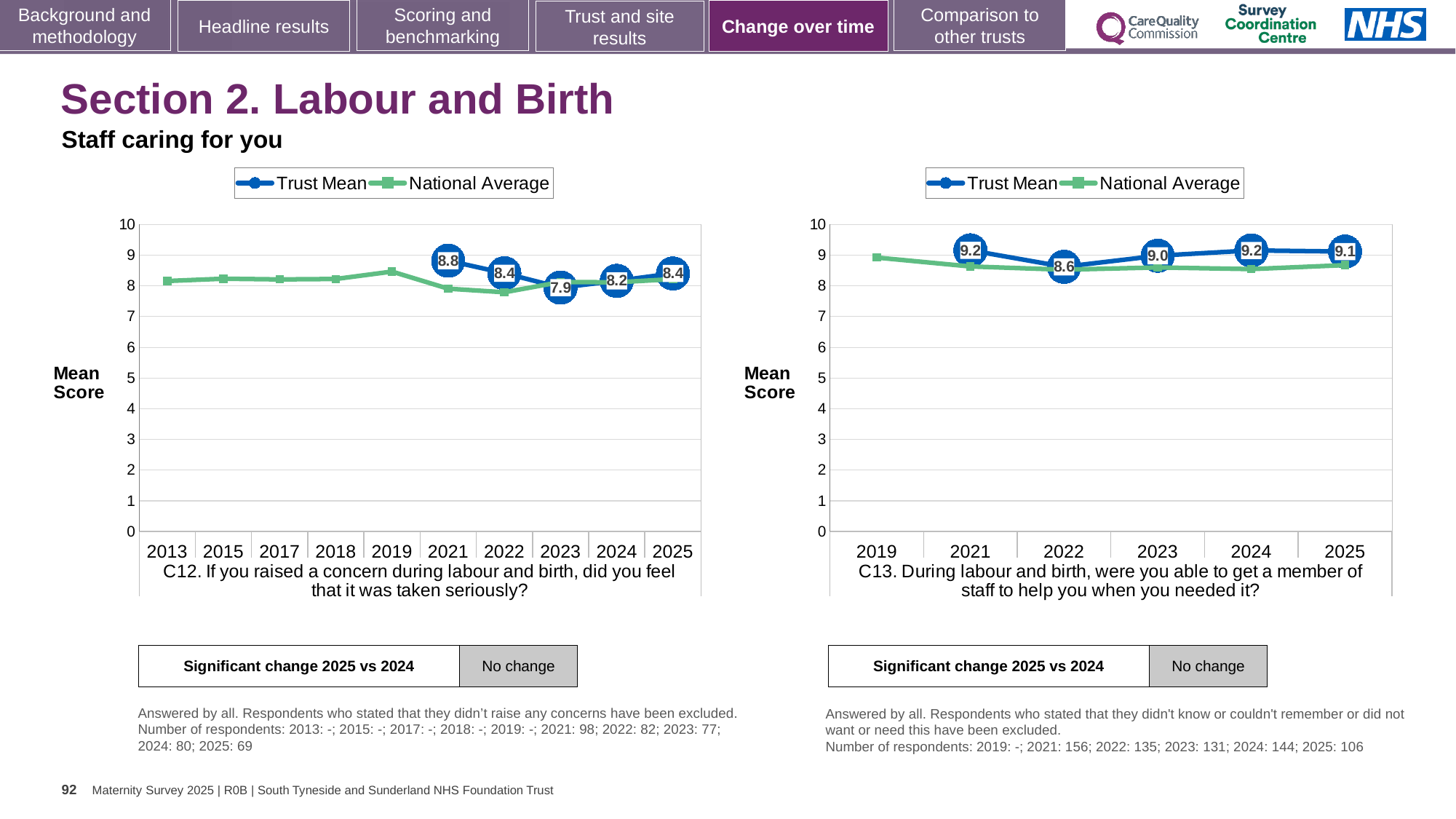
In the C12 chart (left), which year has the highest labelled Trust Mean? 2021 In the C12 chart (left), which year has the lowest labelled Trust Mean? 2023 In the C12 chart (left), what is the Trust Mean for 2021? 8.8 In the C13 chart (right), what is the Trust Mean for 2025? 9.1 In the C13 chart (right), what is the Trust Mean for 2022? 8.6 In the C12 chart (left), what is the Trust Mean for 2023? 7.9 In the C13 chart (right), is the Trust Mean for 2023 larger or smaller than the Trust Mean for 2022? larger In the C13 chart (right), is the National Average for 2019 greater or less than 8? greater In the C12 chart (left), how many years are shown on the x axis? 10 In the C12 chart (left), what is the difference between the Trust Mean for 2021 and 2023? 0.9 How many series does the legend of the C13 chart (right) list? 2 In the C13 chart (right), which year has the lowest labelled Trust Mean? 2022